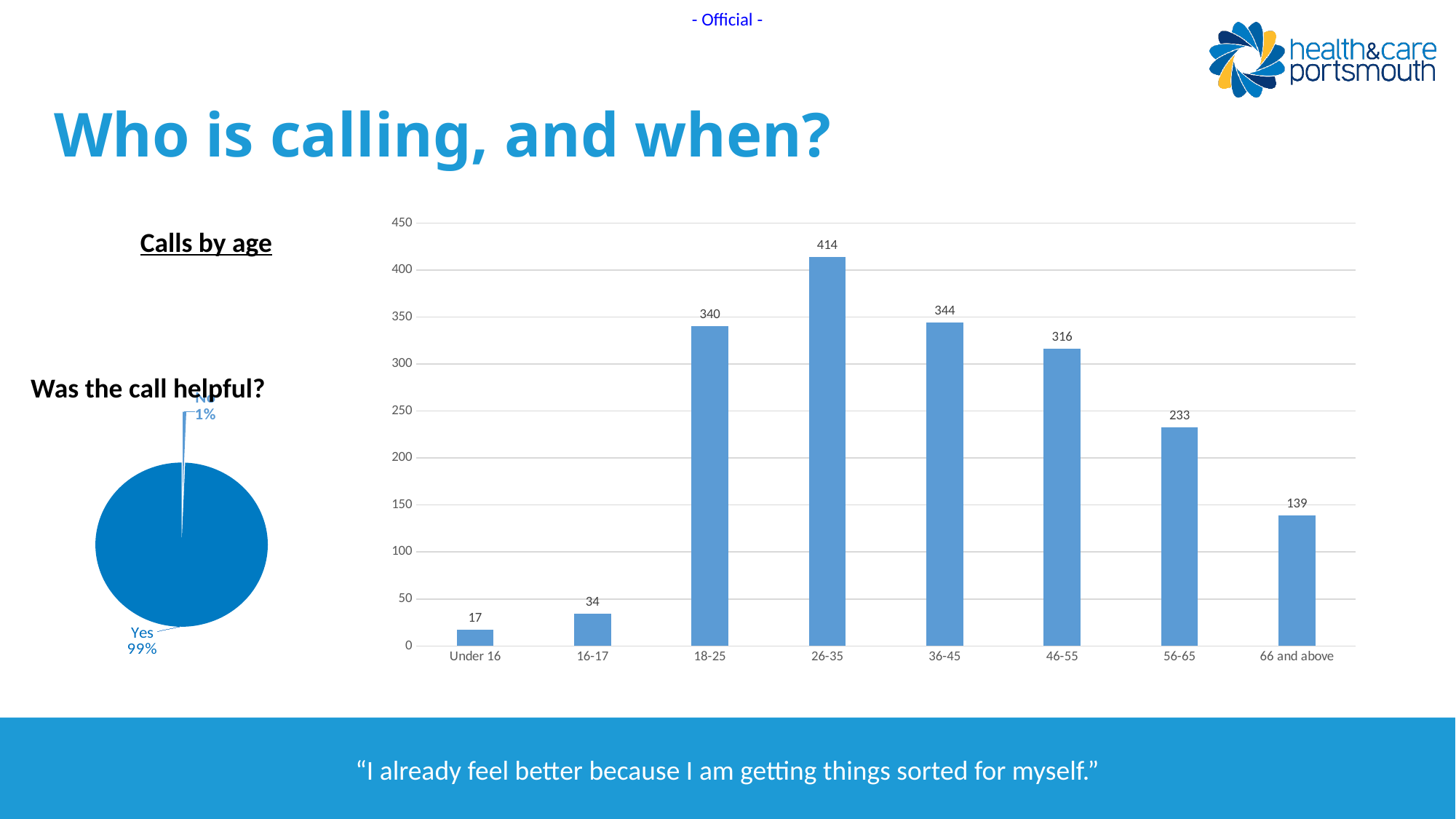
In the Calls by age chart, which age group has the highest number of calls? 26-35 In the Was the call helpful? chart, what share of responses were Yes? 99% In the Calls by age chart, which has more calls, 18-25 or 46-55? 18-25 What kind of chart is the Calls by age chart? bar chart How many age groups are shown in the Calls by age chart? 8 In the Calls by age chart, how many calls were from the 26-35 age group? 414 What kind of chart is the Was the call helpful? chart? pie chart In the Calls by age chart, what is the difference between the calls for 26-35 and 36-45? 70 In the Calls by age chart, how many calls were from the 66 and above age group? 139 In the Was the call helpful? chart, what share of responses were No? 1% In the Calls by age chart, is the value for 56-65 greater or less than 250? less In the Calls by age chart, which age group has the lowest number of calls? Under 16